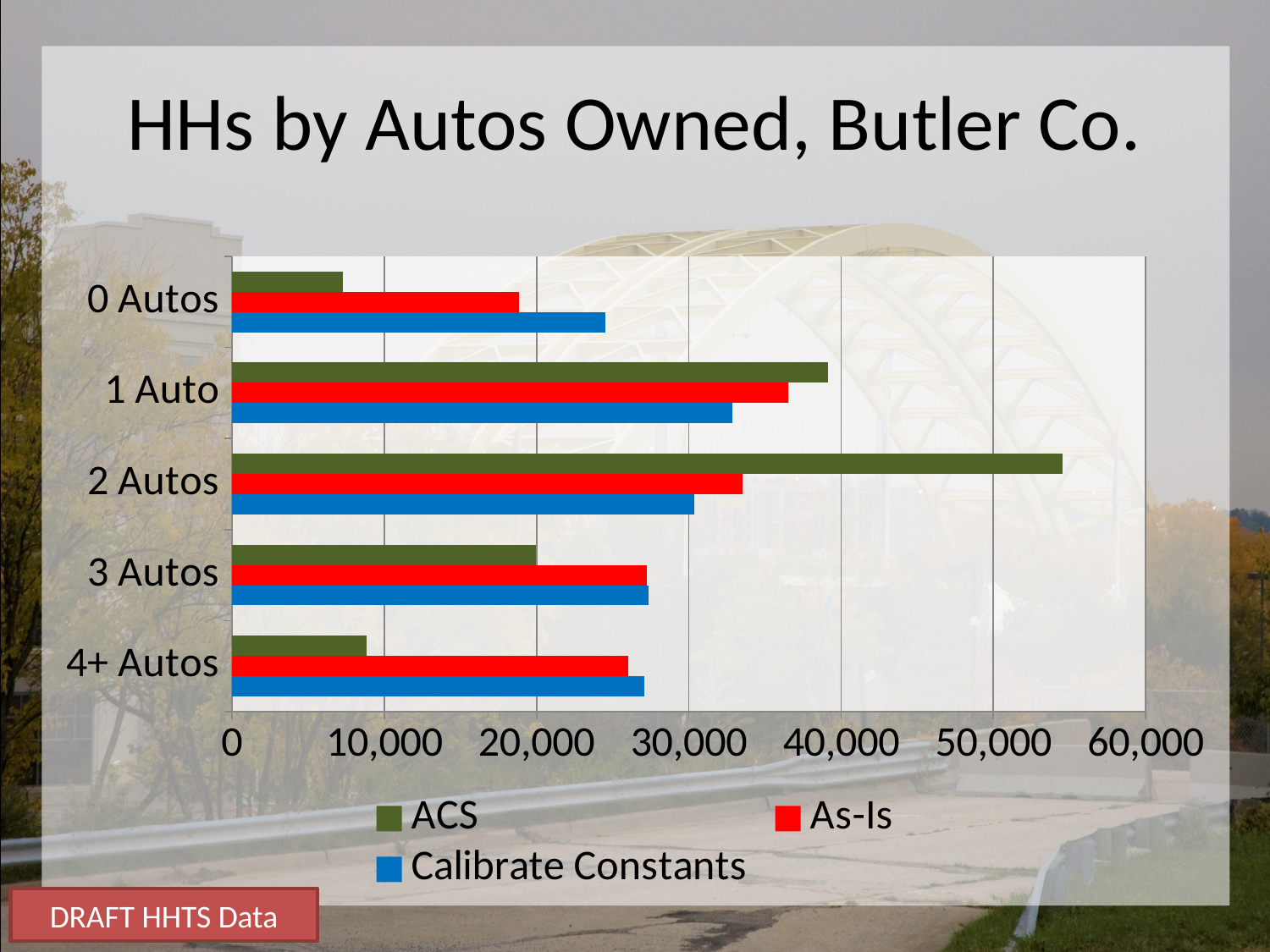
Is the As-Is value for 1 Auto greater or less than 30,000? greater For 4+ Autos, which is larger: the ACS value or the As-Is value? As-Is What is the title of the chart? HHs by Autos Owned, Butler Co. Is the ACS value for 0 Autos greater or less than 10,000? less Which category has the lowest ACS value? 0 Autos What kind of chart is shown on the slide? bar chart Which category has the highest ACS value? 2 Autos Is the ACS value for 2 Autos greater or less than 50,000? greater How many auto-ownership categories are shown on the chart? 5 How many series does the legend list? 3 For 0 Autos, which is larger: the Calibrate Constants value or the ACS value? Calibrate Constants Which colour represents the As-Is series in the legend? red